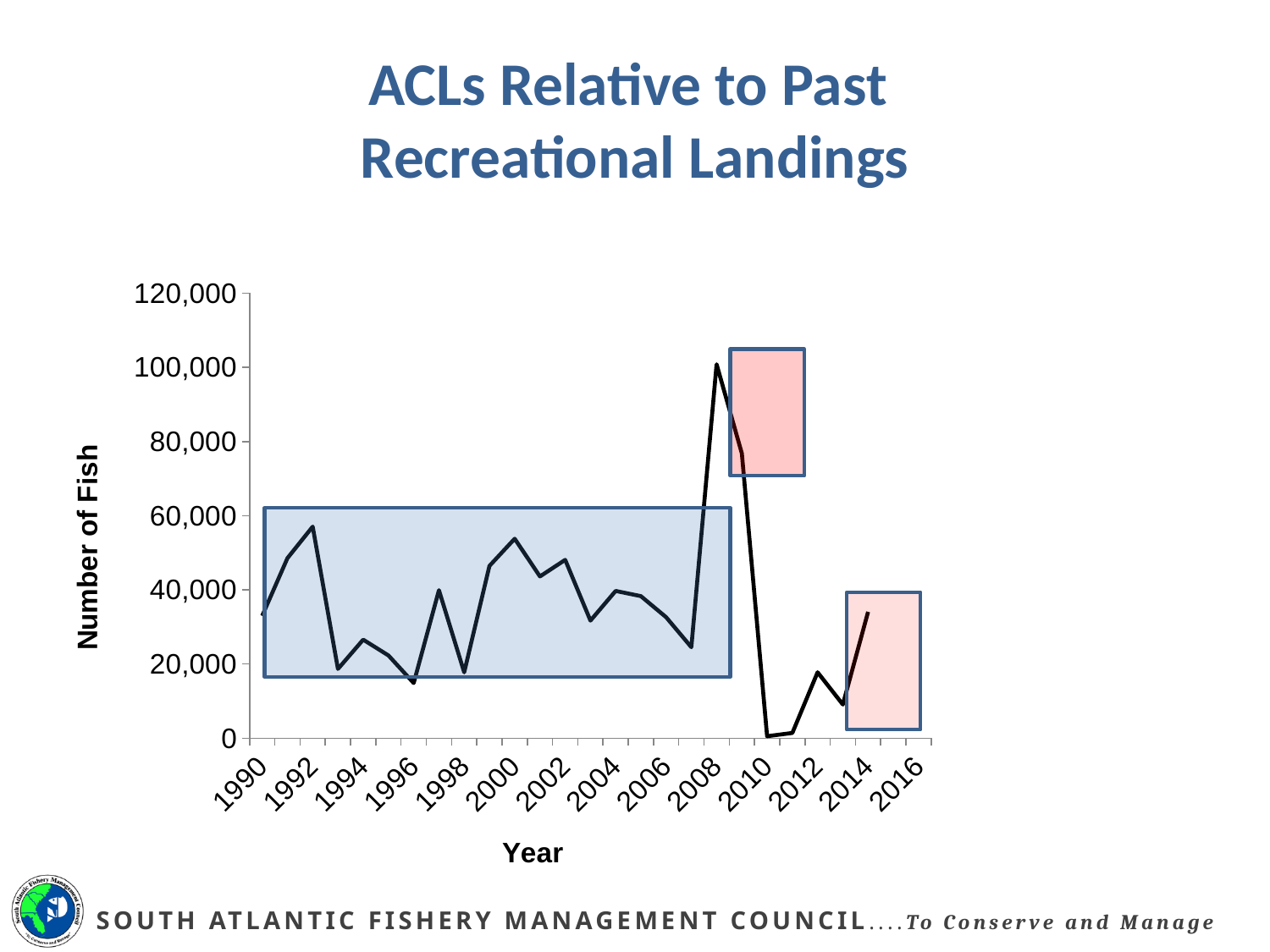
What is the label on the horizontal axis of the chart? Year Which year has the larger number of fish, 1992 or 1993? 1992 What is the label on the vertical axis of the chart? Number of Fish Do the values rise or fall from 2008 to 2010? fall Is the value for 2000 greater or less than 40,000? greater Is the value for 2014 greater or less than 20,000? greater Is the value for 1996 greater or less than 20,000? less Which year has the larger number of fish, 2008 or 2000? 2008 What kind of chart is shown on the slide? line chart Which year has the highest number of fish on the chart? 2008